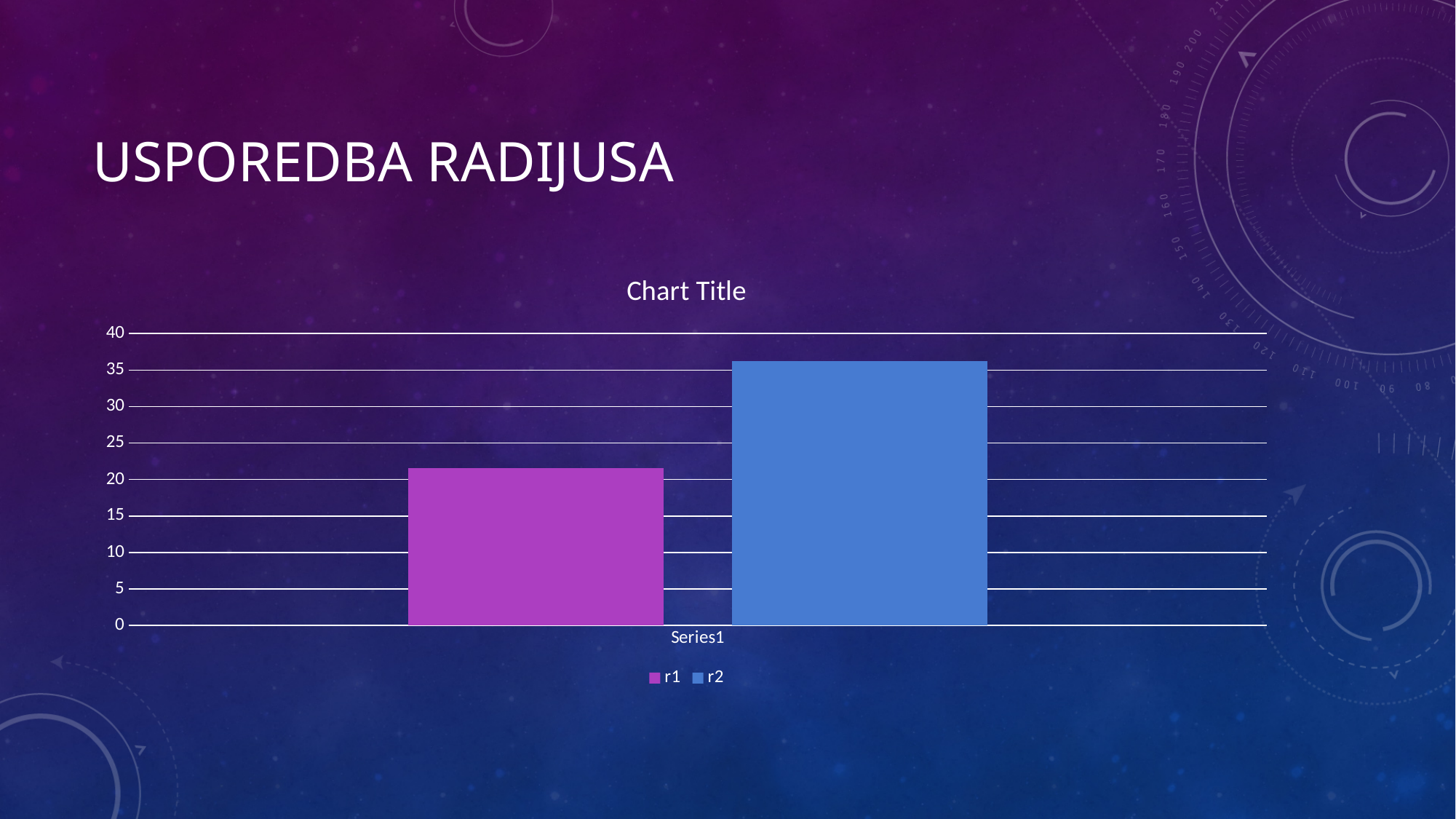
Is the value for r1 greater or less than 20? greater Is the value for r2 greater or less than 40? less Is the value for r2 greater or less than 30? greater What colour is the bar for series r2? blue Which series has the highest bar in the chart? r2 What kind of chart is shown on the slide? bar chart How many series does the chart legend list? 2 Which is larger, the value for r1 or the value for r2? r2 How many categories are shown on the x axis of the chart? 1 Which series has the lowest bar in the chart? r1 What is the title of the chart? Chart Title